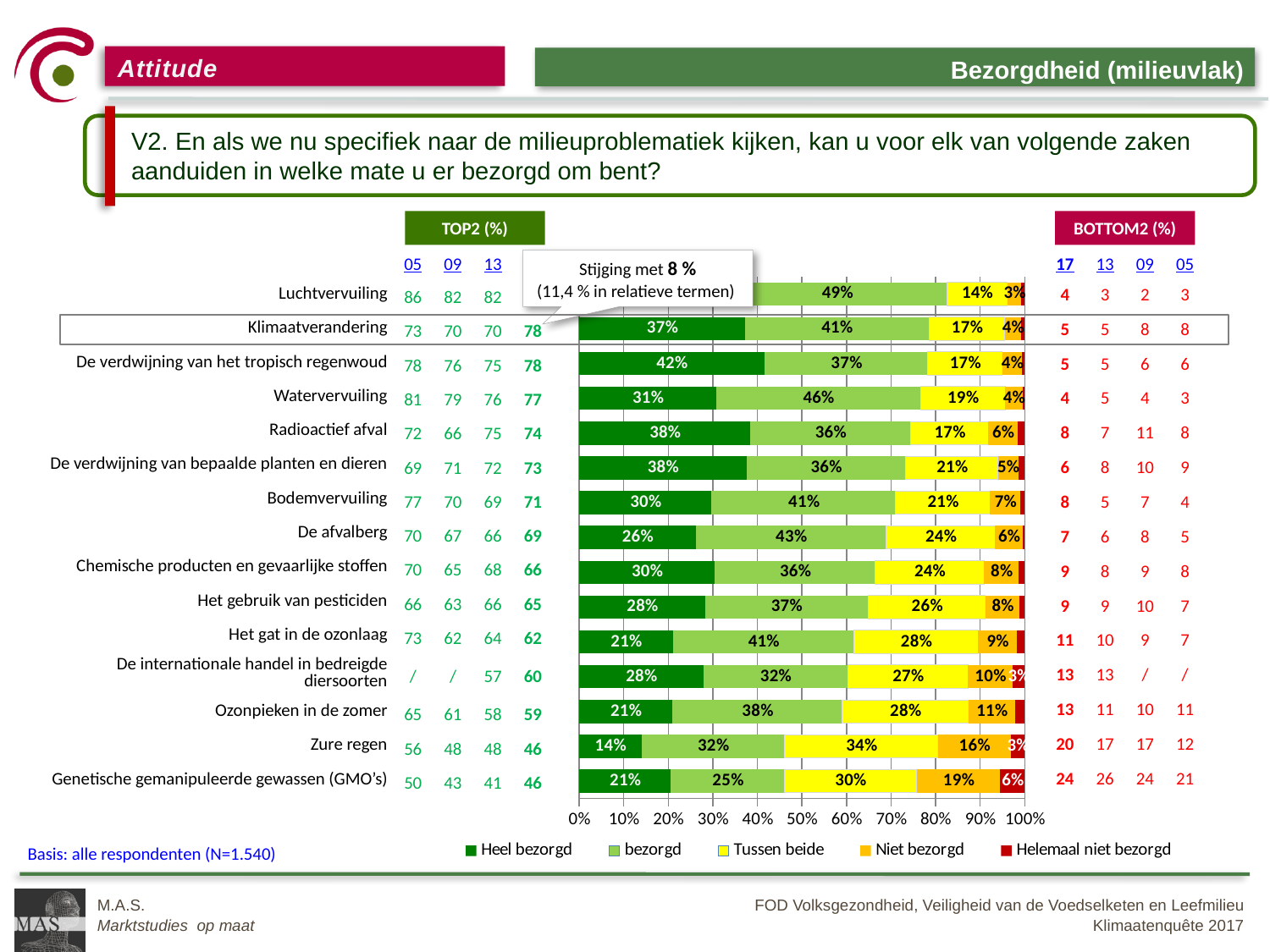
Which category has the highest 'Tussen beide' value? Zure regen What is the 'Heel bezorgd' value for Zure regen? 14% What is the 'Niet bezorgd' value for Genetische gemanipuleerde gewassen (GMO's)? 19% Which has the larger 'Heel bezorgd' value, Radioactief afval or Bodemvervuiling? Radioactief afval How many series does the chart legend list? 5 Which category has the lowest 'Heel bezorgd' value? Zure regen What is the difference between the 'Tussen beide' values for Zure regen and Luchtvervuiling? 20 percentage points What kind of chart is shown on the slide? bar chart What is the 'Tussen beide' value for Het gat in de ozonlaag? 28% What is the 'bezorgd' value for Watervervuiling? 46% Which category has the highest 'bezorgd' value? Luchtvervuiling How many categories (environmental issues) are plotted in the chart? 15